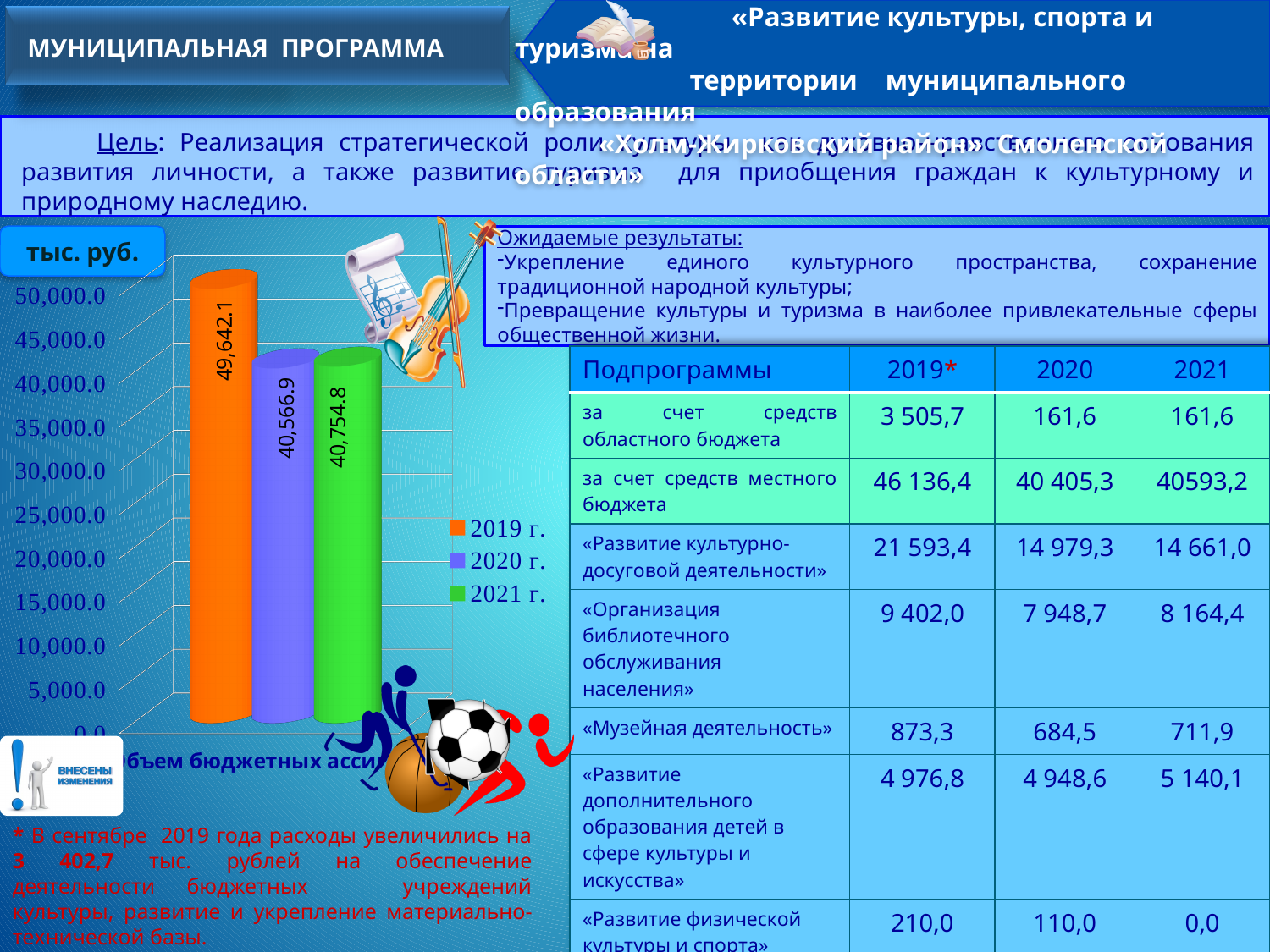
Is the value for 2020 г. greater or less than 45,000.0? less How many entries does the chart legend list? 3 What type of chart is shown on the slide? bar chart Which year has the lowest value on the bar chart? 2020 г. How many bars are plotted on the chart? 3 Which year has the highest value on the bar chart? 2019 г. Is the value for 2019 г. greater or less than 45,000.0? greater What value is shown for 2020 г. on the bar chart? 40,566.9 What is the difference between the values for 2021 г. and 2020 г. on the bar chart? 187.9 What value is shown for 2021 г. on the bar chart? 40,754.8 What is the difference between the values for 2019 г. and 2020 г. on the bar chart? 9,075.2 What value is shown for 2019 г. on the bar chart? 49,642.1